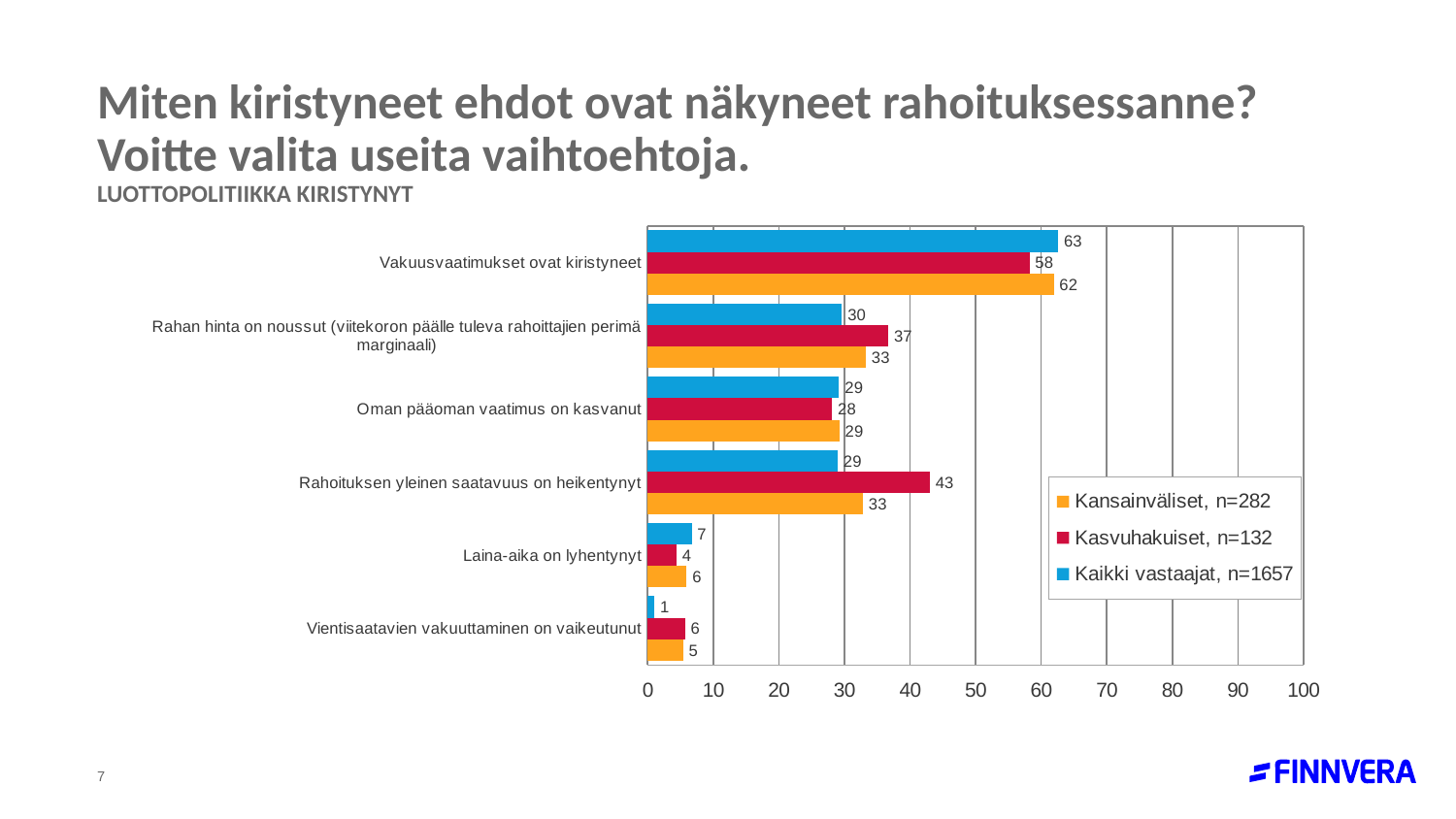
How many categories are shown on the chart? 6 In the category 'Rahan hinta on noussut (viitekoron päälle tuleva rahoittajien perimä marginaali)', which series has the larger value: 'Kasvuhakuiset, n=132' or 'Kaikki vastaajat, n=1657'? Kasvuhakuiset, n=132 What is the value for 'Kasvuhakuiset, n=132' in the category 'Rahoituksen yleinen saatavuus on heikentynyt'? 43 Which category has the lowest value for 'Kaikki vastaajat, n=1657'? Vientisaatavien vakuuttaminen on vaikeutunut What is the difference between the 'Kasvuhakuiset, n=132' and 'Kaikki vastaajat, n=1657' values in the category 'Rahoituksen yleinen saatavuus on heikentynyt'? 14 How many series does the legend list? 3 Which category has the highest value for 'Kaikki vastaajat, n=1657'? Vakuusvaatimukset ovat kiristyneet What kind of chart is shown on the slide? Bar chart What is the value for 'Kansainväliset, n=282' in the category 'Laina-aika on lyhentynyt'? 6 Which colour represents the series 'Kasvuhakuiset, n=132' in the chart? Red Is the value for 'Kansainväliset, n=282' in the category 'Vakuusvaatimukset ovat kiristyneet' greater or less than 50? greater What is the value for 'Kaikki vastaajat, n=1657' in the category 'Vakuusvaatimukset ovat kiristyneet'? 63